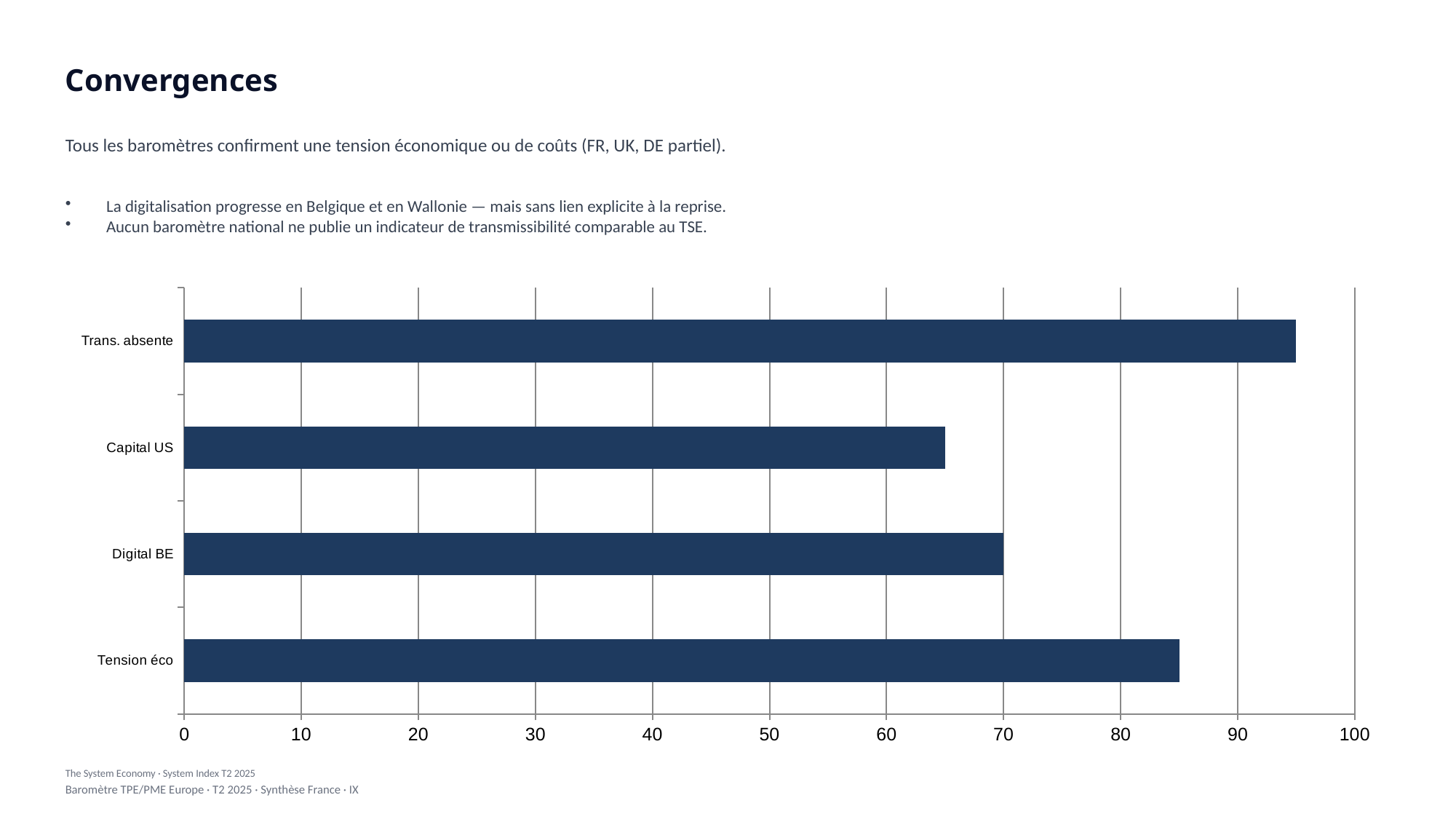
Is the value for Capital US greater or less than 70? less Which is larger, the value for Tension éco or the value for Digital BE? Tension éco Which is larger, the value for Capital US or the value for Trans. absente? Trans. absente How many categories are plotted in the bar chart? 4 What is the value for Digital BE? 70 Is the value for Trans. absente greater or less than 90? greater What is the maximum value shown on the horizontal axis of the chart? 100 What kind of chart is shown on the slide? bar chart Which category has the lowest value in the bar chart? Capital US Which category has the highest value in the bar chart? Trans. absente Is the value for Tension éco greater or less than 80? greater